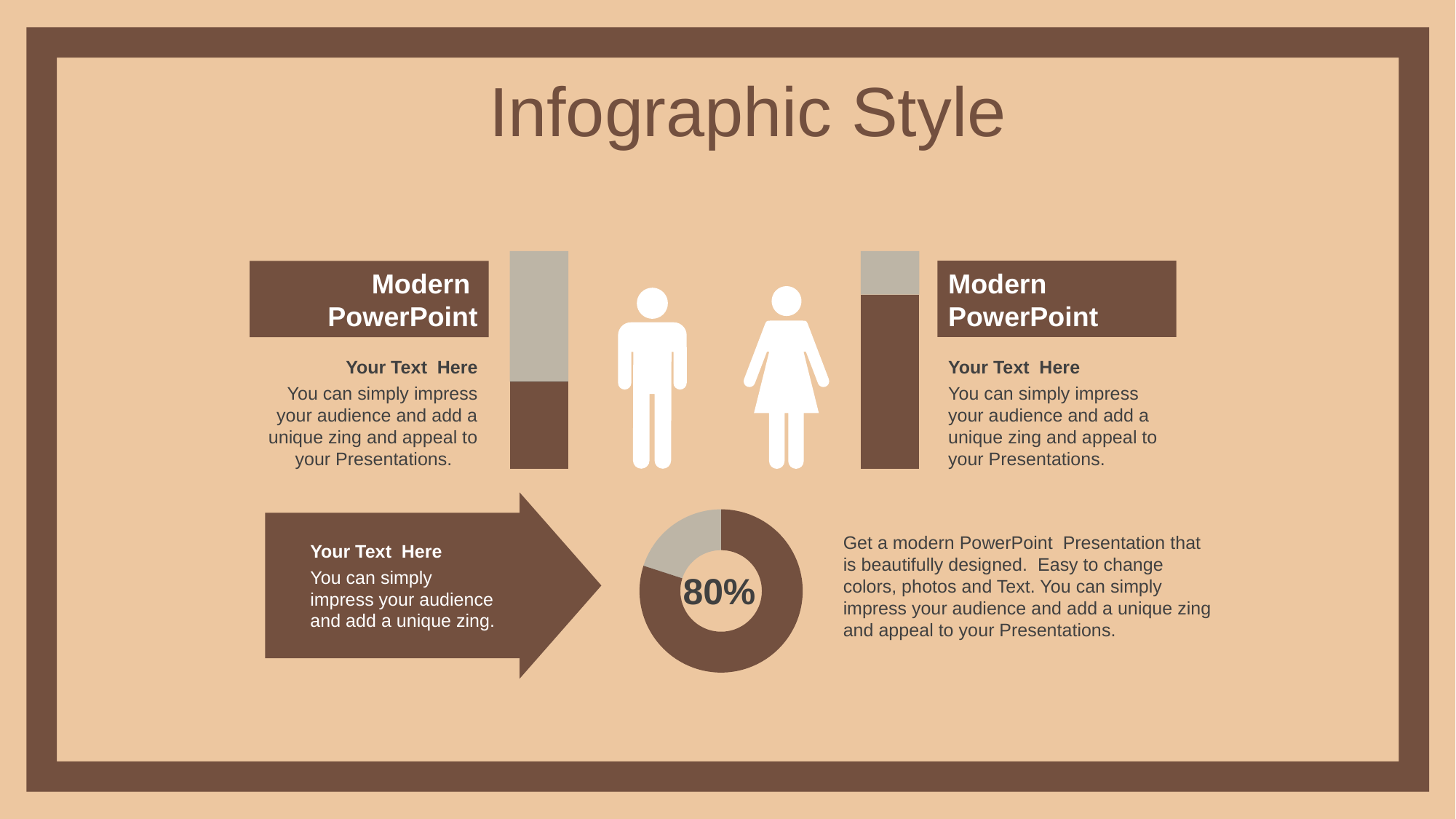
What kind of chart is shown in the lower middle of the slide with the 80% label? donut chart How many segments does the donut chart have? 2 Which vertical bar has the larger dark brown filled portion, the one beside the male icon or the one beside the female icon? the one beside the female icon Is the dark brown segment of the donut chart greater or less than 50% of the ring? greater What colour is the larger segment of the donut chart? dark brown Is the dark brown filled portion of the vertical bar beside the female icon greater or less than half of the bar? greater Is the dark brown filled portion of the vertical bar beside the male icon greater or less than half of the bar? less In the donut chart, which segment is larger, the dark brown one or the light grey one? dark brown What percentage is printed in the centre of the donut chart? 80% What is the title of the slide containing the donut chart? Infographic Style